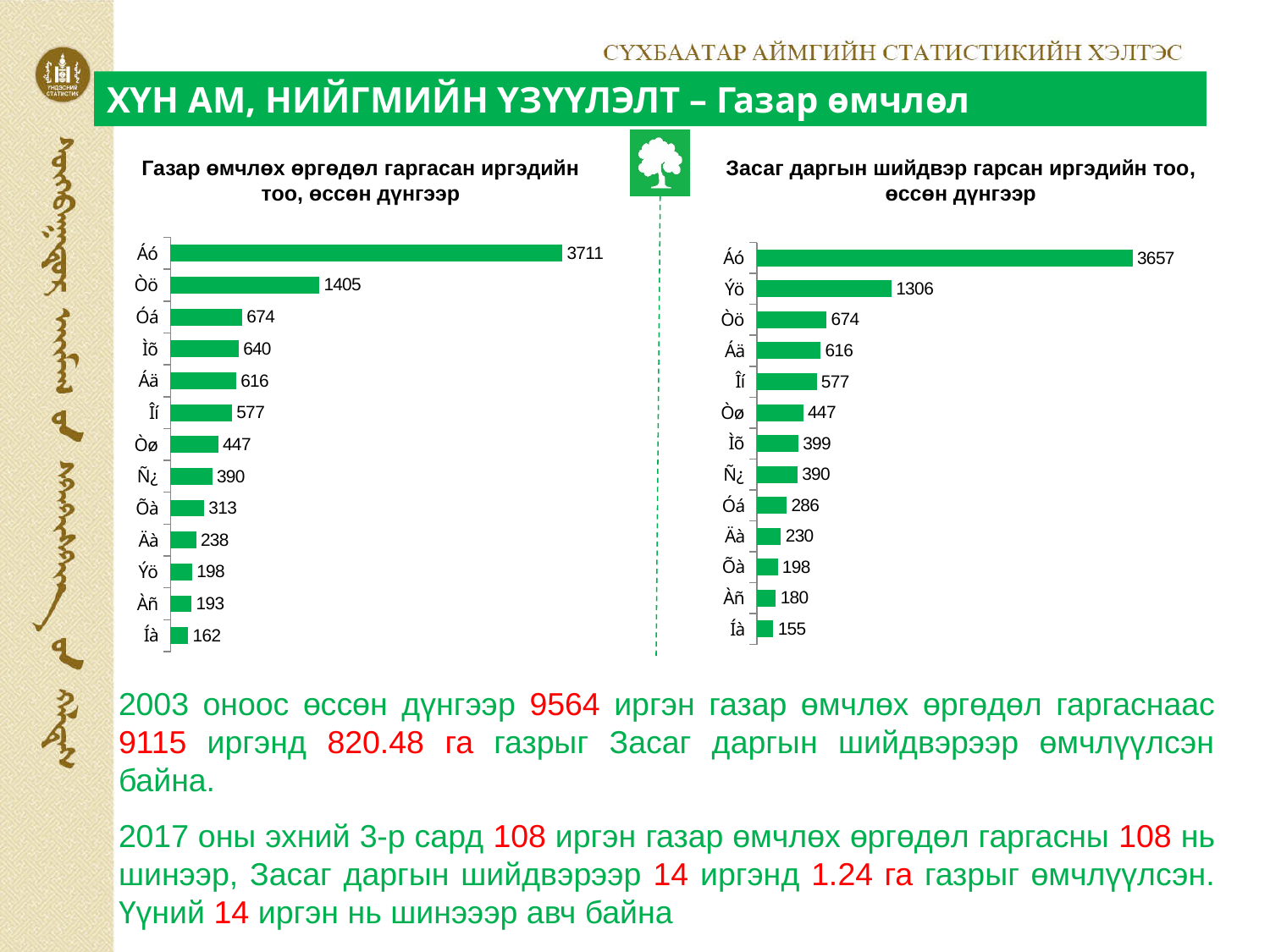
In the right chart, what is the value for the category Ýö? 1306 What type of chart is the left chart? Bar chart In the left chart, which is larger: the value for Óá or the value for Ìõ? Óá In the right chart, what is the difference between the values for Áó and Ýö? 2351 In the left chart, what is the difference between the values for Áó and Òö? 2306 In the left chart (Газар өмчлөх өргөдөл гаргасан иргэдийн тоо), what is the value of the top bar labelled Áó? 3711 In the right chart, what is the value of the bottom bar labelled Íà? 155 In the left chart, what is the value for the category Òö? 1405 In the left chart, which category has the lowest value? Íà In the right chart, which category has the highest value? Áó How many categories are shown in the right chart? 13 In the right chart (Засаг даргын шийдвэр гарсан иргэдийн тоо), what is the value of the top bar labelled Áó? 3657